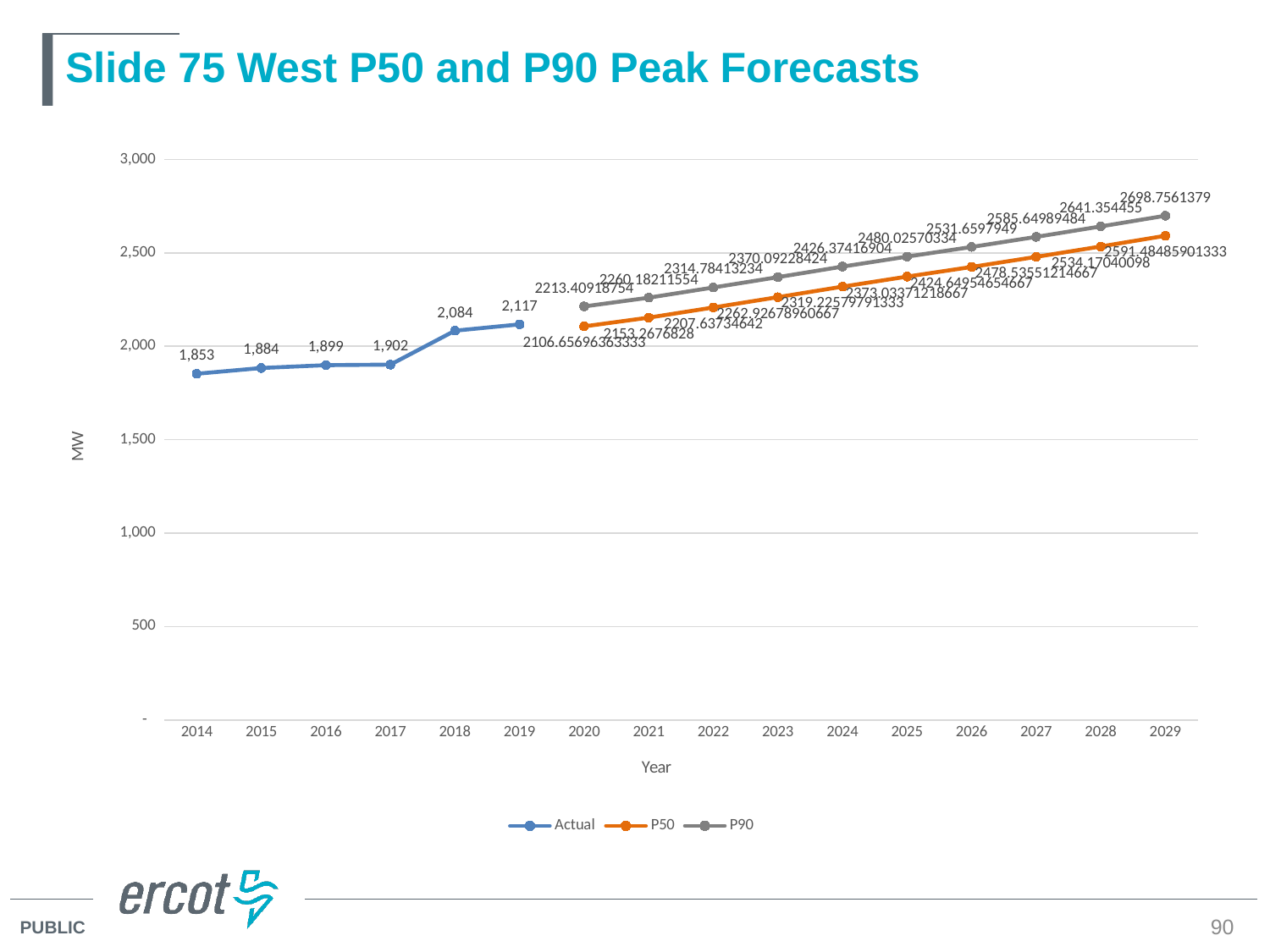
What kind of chart is shown on the slide? line chart How many series does the legend list? 3 Is the P90 value for 2029 greater or less than 2,500? greater What is the Actual value for 2014? 1,853 Which year has the highest P90 value? 2029 What is the P90 value for 2029? 2698.7561379 What is the P50 value for 2020? 2106.65696363333 What is the difference between the Actual values for 2019 and 2014? 264 Do the P50 values rise or fall from 2020 to 2029? rise Which year has the lowest Actual value? 2014 What is the Actual value for 2019? 2,117 Which is larger in 2029, the P50 value or the P90 value? P90